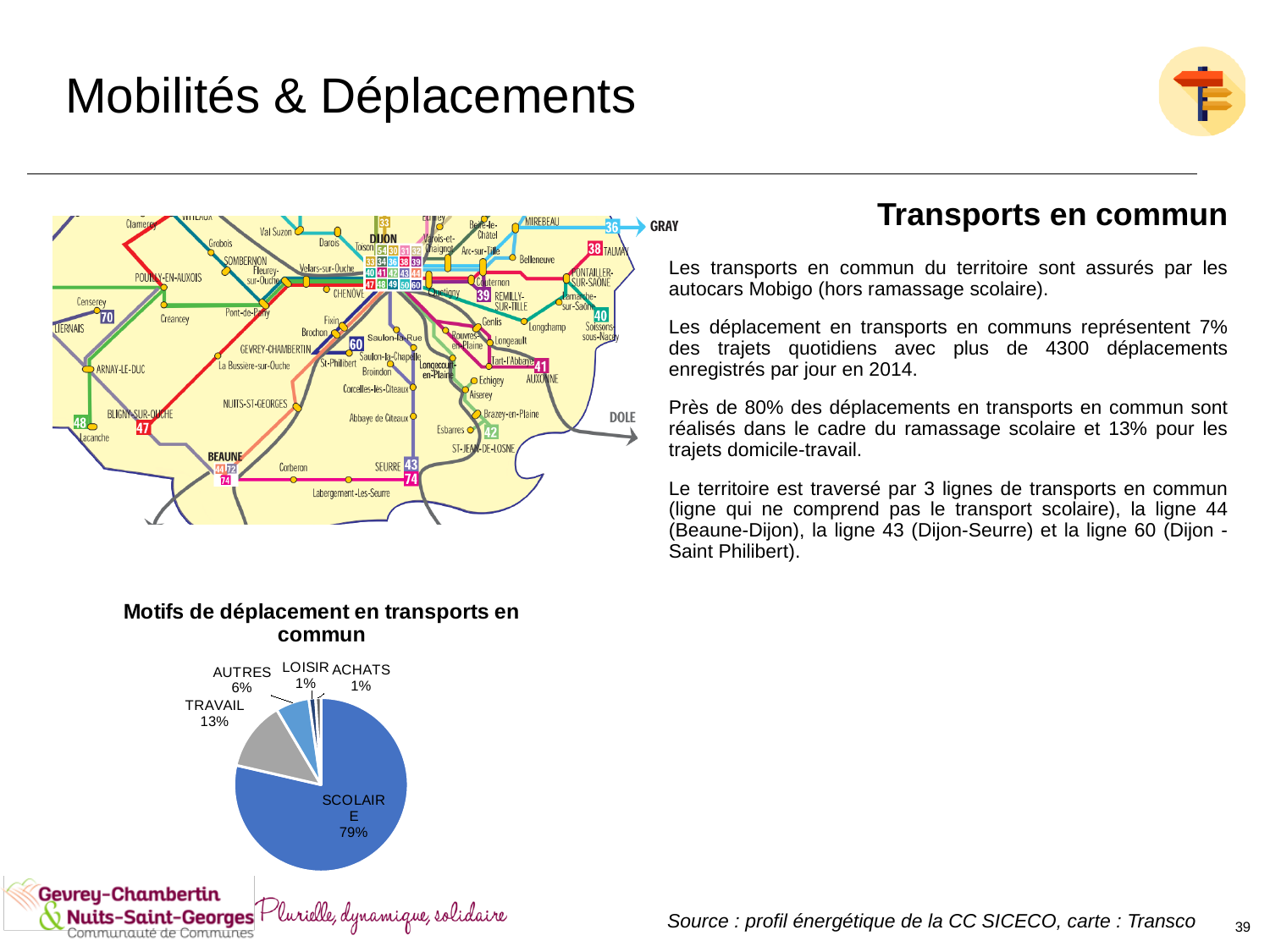
In the pie chart, what share is shown for LOISIR? 1% In the pie chart, what is the combined share of TRAVAIL and AUTRES? 19% How many categories (slices) does the pie chart show? 5 In the pie chart, what share is shown for ACHATS? 1% What is the title of the pie chart on the slide? Motifs de déplacement en transports en commun Which category has the largest slice in the pie chart? SCOLAIRE In the pie chart, what is the difference in percentage points between SCOLAIRE and TRAVAIL? 66 What kind of chart is shown under the title "Motifs de déplacement en transports en commun"? pie chart In the pie chart, what share is shown for SCOLAIRE? 79% In the pie chart, which is larger: TRAVAIL or AUTRES? TRAVAIL In the pie chart, what share is shown for TRAVAIL? 13% In the pie chart, what share is shown for AUTRES? 6%